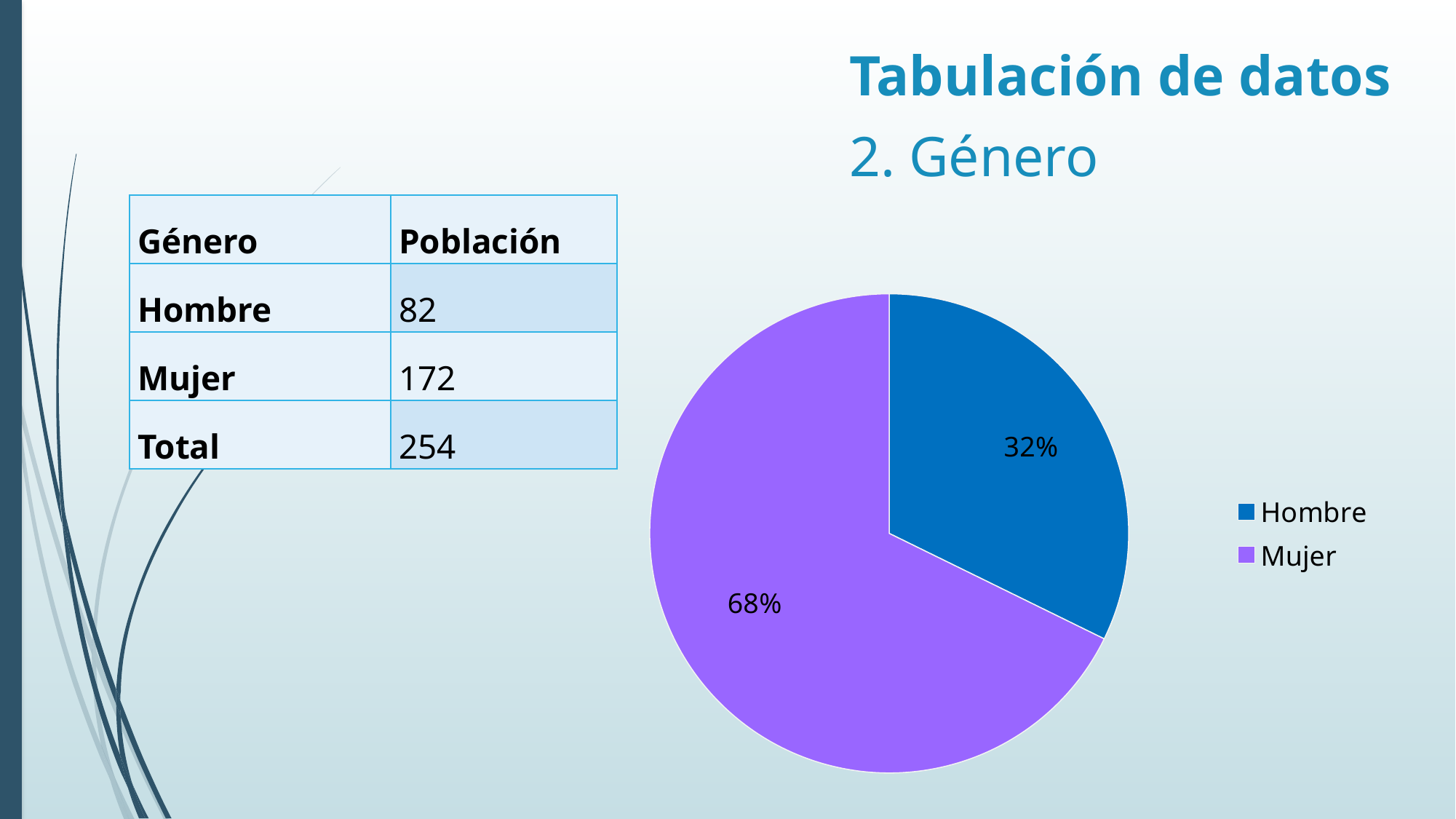
What kind of chart is shown on the slide? pie chart How many entries does the legend list? 2 What colour is the Mujer slice in the pie chart? purple How many slices does the pie chart have? 2 What colour is the Hombre slice in the pie chart? blue What share of the pie does Hombre represent? 32% What is the difference in percentage points between the Mujer and Hombre slices? 36 Which slice is larger, Hombre or Mujer? Mujer Which slice of the pie is the smallest? Hombre Which slice of the pie is the largest? Mujer What share of the pie does Mujer represent? 68%